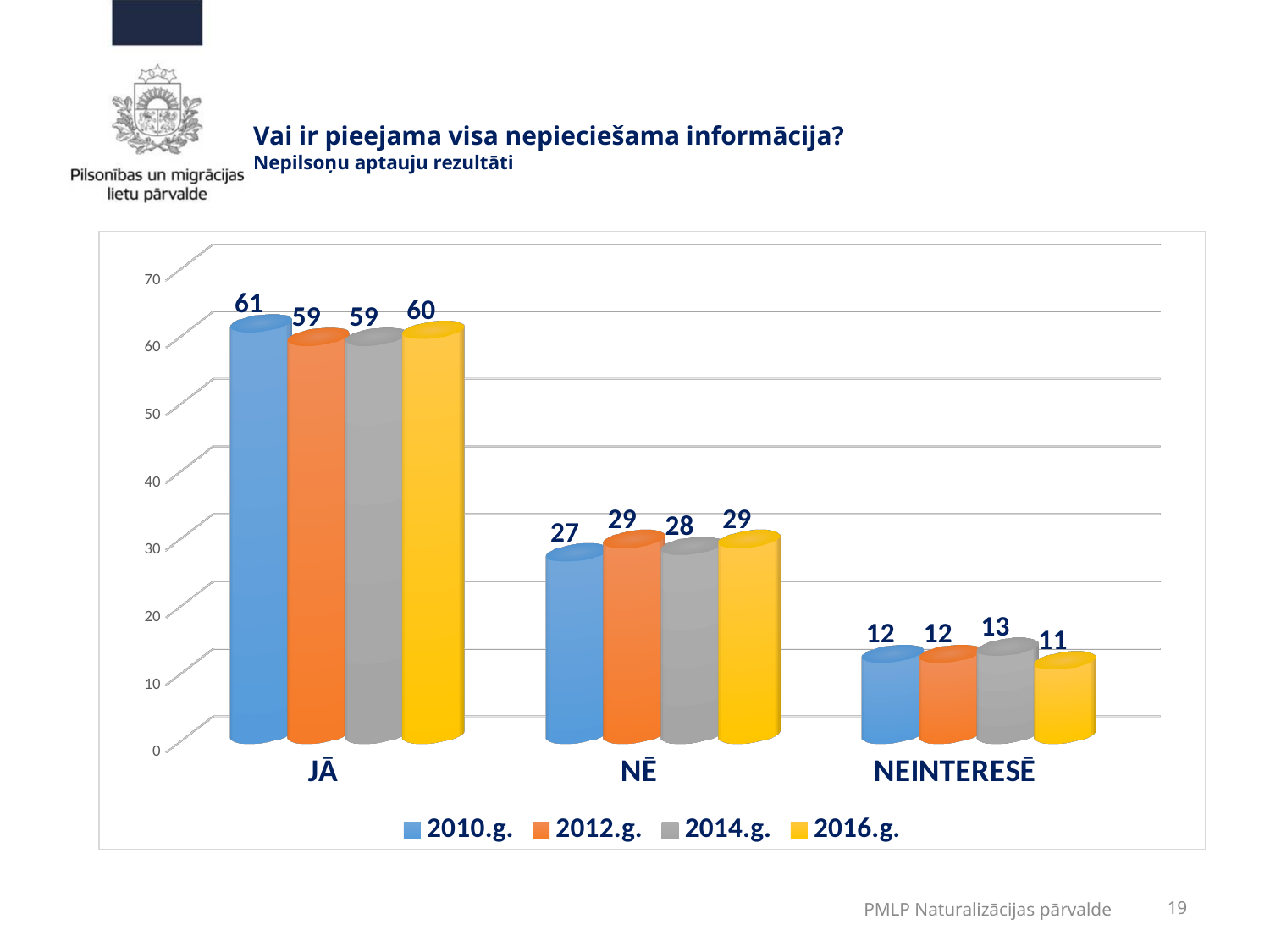
How many series does the legend list? 4 What is the value for NEINTERESĒ in 2016.g.? 11 What is the value for NĒ in 2014.g.? 28 Is the value for NĒ in 2012.g. greater or less than 20? greater Which is larger for JĀ: the 2010.g. value or the 2016.g. value? 2010.g. What is the difference between the 2010.g. and 2016.g. values for NĒ? 2 Which colour represents 2014.g. in the legend? grey Which category has the highest value in 2012.g.? JĀ Which category has the lowest value in 2014.g.? NEINTERESĒ What kind of chart is shown on the slide? bar chart What is the value for JĀ in 2010.g.? 61 How many categories are shown on the x axis? 3